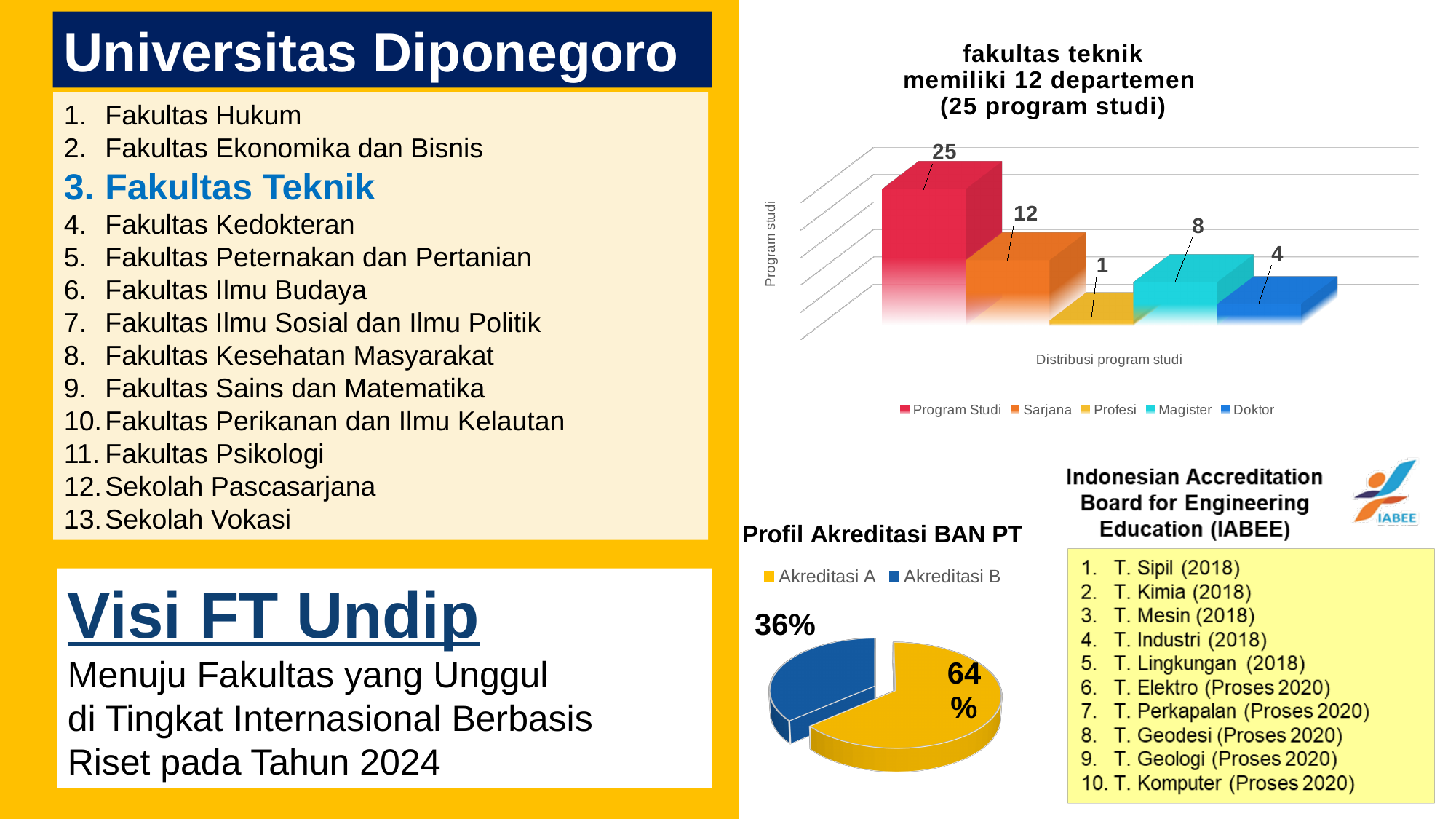
How many series does the legend of the bar chart titled 'fakultas teknik memiliki 12 departemen (25 program studi)' list? 5 In the bar chart titled 'fakultas teknik memiliki 12 departemen (25 program studi)', what is the value for Doktor? 4 In the bar chart titled 'fakultas teknik memiliki 12 departemen (25 program studi)', which series has the highest value? Program Studi What kind of chart is the chart titled 'fakultas teknik memiliki 12 departemen (25 program studi)'? Bar chart What kind of chart is the chart titled 'Profil Akreditasi BAN PT'? Pie chart In the bar chart titled 'fakultas teknik memiliki 12 departemen (25 program studi)', what is the value for Sarjana? 12 In the bar chart titled 'fakultas teknik memiliki 12 departemen (25 program studi)', which series has the lowest value? Profesi In the bar chart titled 'fakultas teknik memiliki 12 departemen (25 program studi)', which is larger, Magister or Doktor? Magister In the pie chart titled 'Profil Akreditasi BAN PT', what share does Akreditasi B have? 36% In the pie chart titled 'Profil Akreditasi BAN PT', what share does Akreditasi A have? 64% In the bar chart titled 'fakultas teknik memiliki 12 departemen (25 program studi)', what is the difference between the Sarjana and Magister values? 4 In the bar chart titled 'fakultas teknik memiliki 12 departemen (25 program studi)', what is the value for Magister? 8